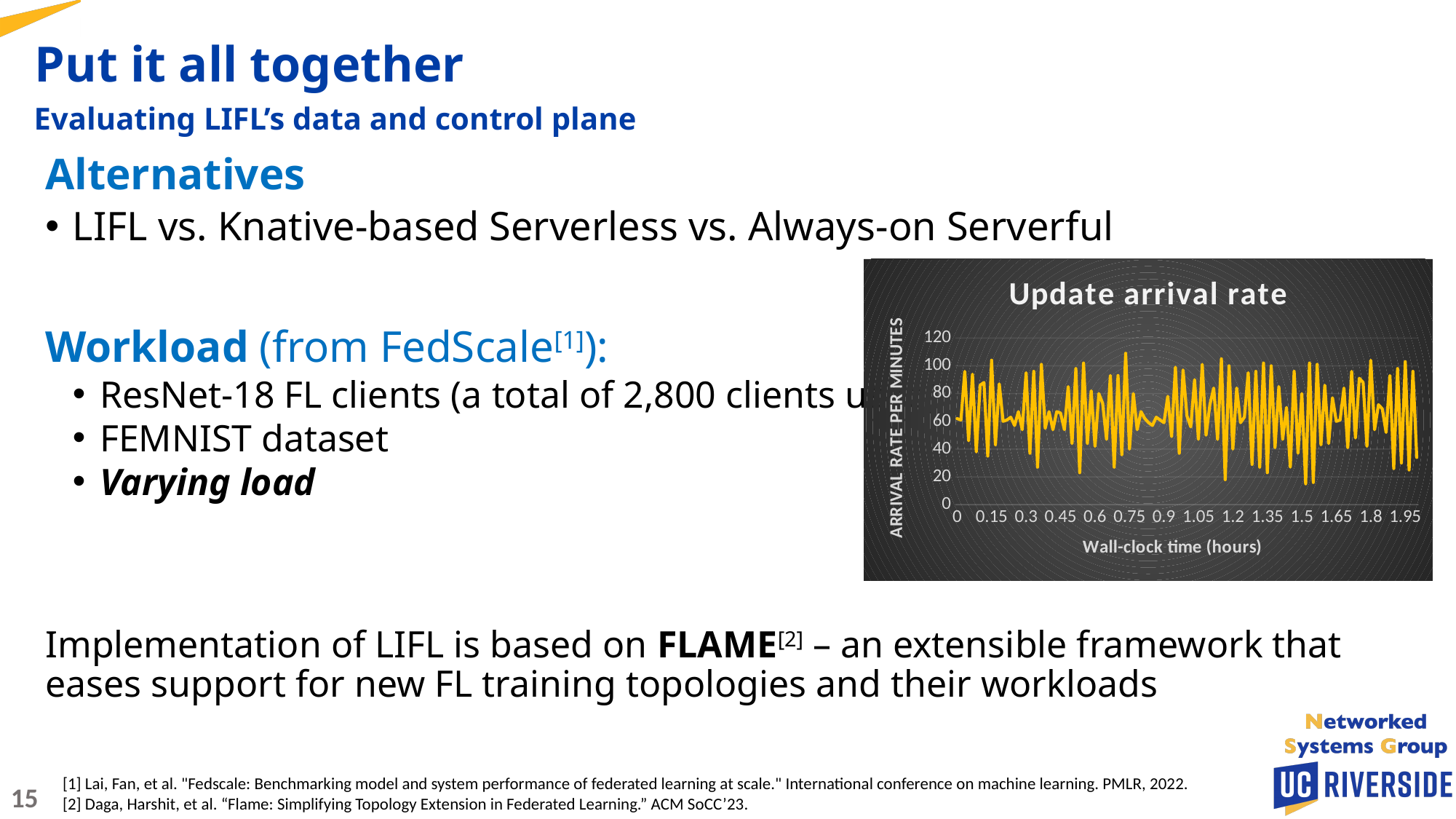
What kind of chart is shown on the slide? line chart What colour is the line plotted in the 'Update arrival rate' chart? yellow/orange What is the largest tick value shown on the y axis of the 'Update arrival rate' chart? 120 Does the arrival rate in the 'Update arrival rate' chart show a steady rise, a steady fall, or fluctuate up and down over wall-clock time? fluctuates up and down How many tick labels are shown on the x axis of the 'Update arrival rate' chart? 14 What is the last tick value shown on the x axis of the 'Update arrival rate' chart? 1.95 In the 'Update arrival rate' chart, is the highest value of the line greater or less than 120? less In the 'Update arrival rate' chart, is the lowest trough of the line greater or less than 40? less What is the title of the chart on the slide? Update arrival rate How many lines (series) are plotted in the 'Update arrival rate' chart? 1 In the 'Update arrival rate' chart, is the highest peak of the line greater or less than 80? greater